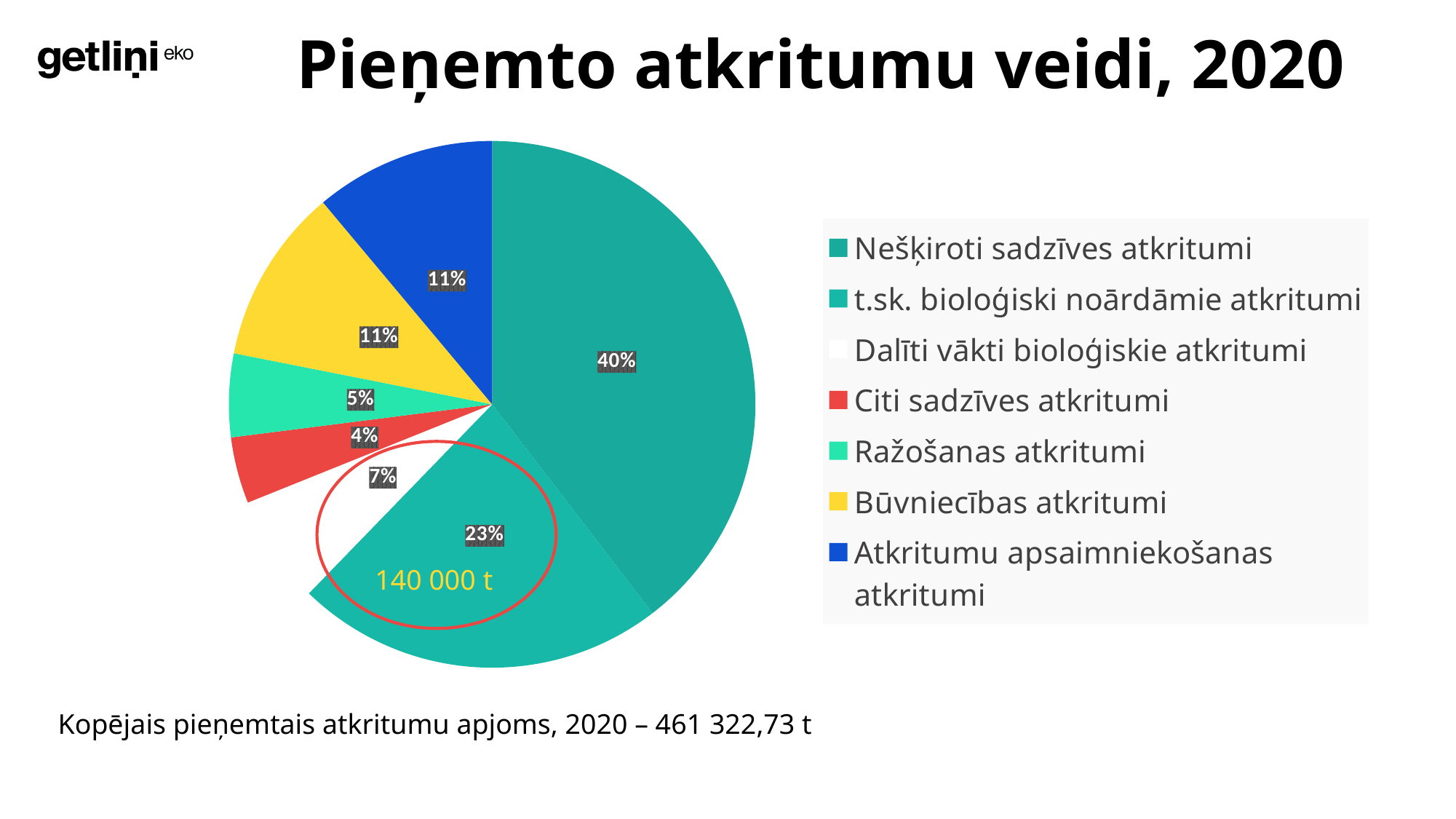
What share of the pie does Dalīti vākti bioloģiskie atkritumi have? 7% What kind of chart is shown on the slide? pie chart What share of the pie does Citi sadzīves atkritumi have? 4% Which category has the smallest slice of the pie? Citi sadzīves atkritumi What is the title of the chart on the slide? Pieņemto atkritumu veidi, 2020 What is the difference in percentage points between the Nešķiroti sadzīves atkritumi slice and the t.sk. bioloģiski noārdāmie atkritumi slice? 17 What share of the pie does Ražošanas atkritumi have? 5% How many categories does the legend of the pie chart list? 7 Which category has the largest slice of the pie? Nešķiroti sadzīves atkritumi